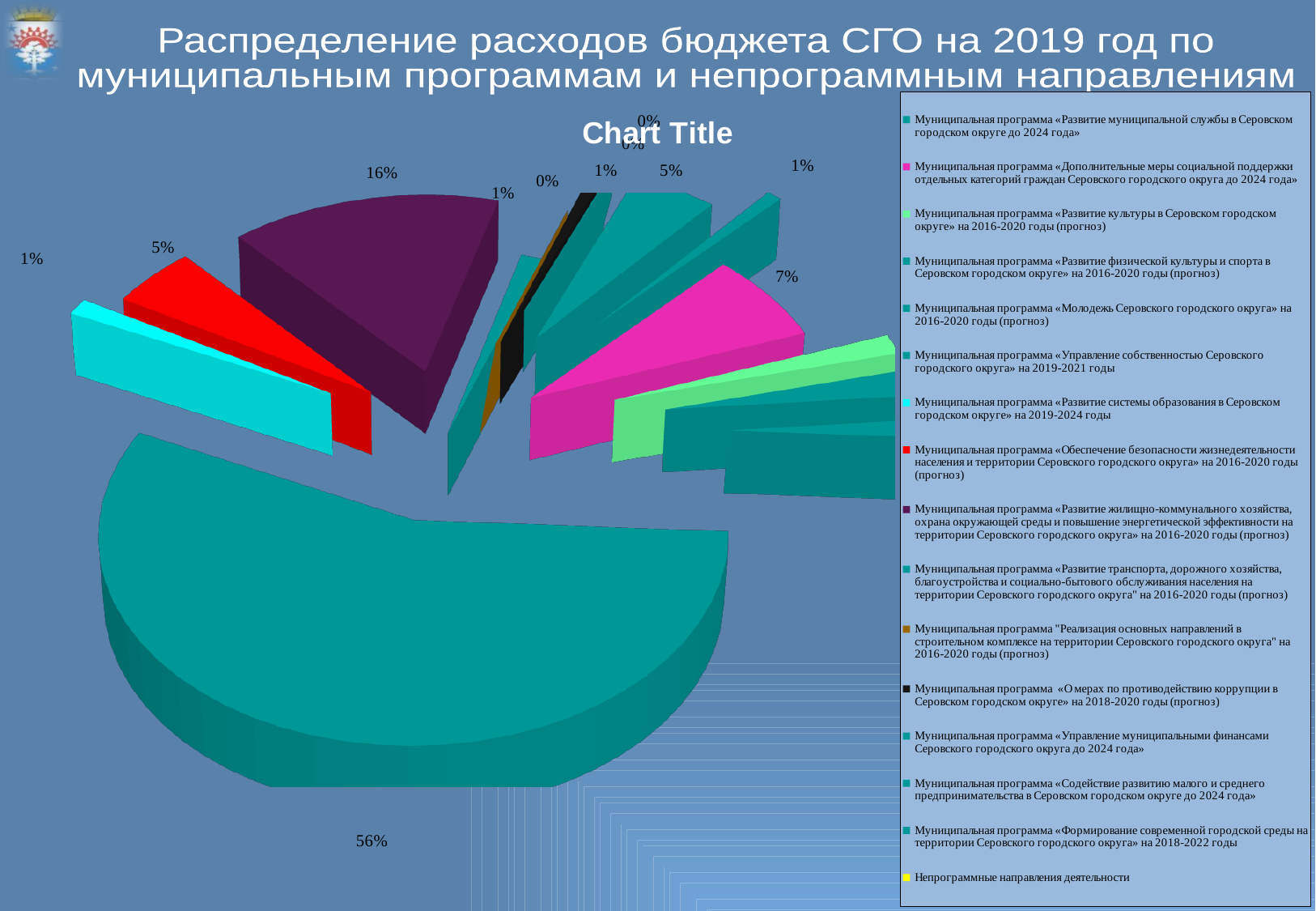
What colour is the legend marker for «Непрограммные направления деятельности»? Yellow What is the title shown above the pie chart? Chart Title What share of the pie is labelled for the magenta slice (Муниципальная программа «Дополнительные меры социальной поддержки отдельных категорий граждан...»)? 7% What kind of chart is shown on the slide? Pie chart By how many percentage points does the purple slice (16%) exceed the magenta slice (7%)? 9 percentage points What share of the pie is labelled for the red slice (Муниципальная программа «Обеспечение безопасности жизнедеятельности населения и территории Серовского городского округа»)? 5% Which is larger: the magenta slice (Дополнительные меры социальной поддержки) or the red slice (Обеспечение безопасности жизнедеятельности)? The magenta slice (Дополнительные меры социальной поддержки) How many entries does the legend of the pie chart list? 16 Which is larger: the purple slice (Развитие жилищно-коммунального хозяйства) or the red slice (Обеспечение безопасности жизнедеятельности)? The purple slice (Развитие жилищно-коммунального хозяйства) What percentage is shown for the largest slice of the pie chart? 56% What share of the pie is labelled for the purple slice (Муниципальная программа «Развитие жилищно-коммунального хозяйства, охрана окружающей среды и повышение энергетической эффективности...»)? 16%